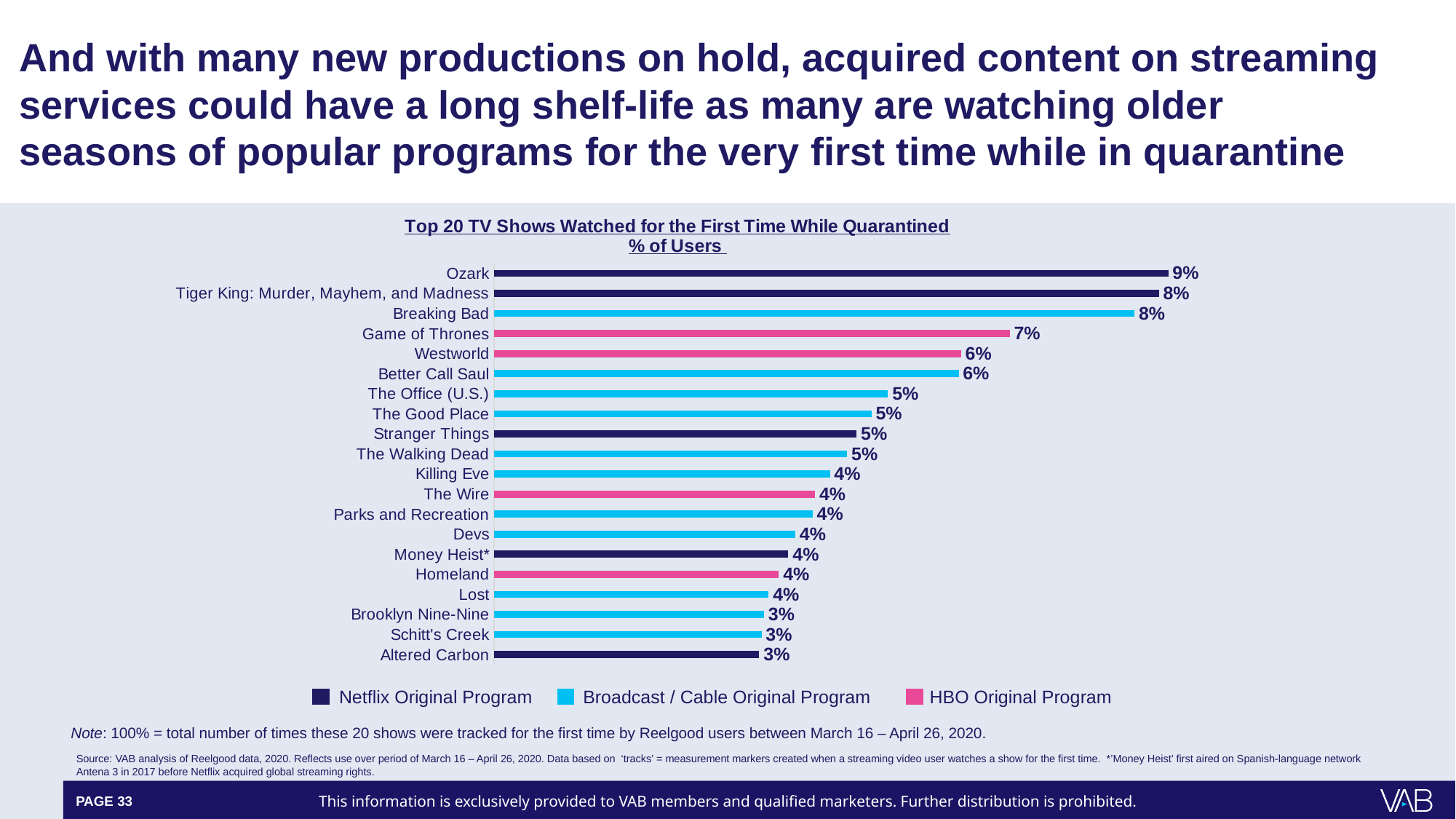
What is the value shown for Better Call Saul? 6% What is the value shown for Altered Carbon? 3% What percentage of users watched Ozark for the first time while quarantined? 9% Which TV show has the highest percentage of users in the chart? Ozark Which legend category is shown in pink? HBO Original Program Which has a larger value, Breaking Bad or Westworld? Breaking Bad How many program categories does the legend list? 3 What is the value shown for Stranger Things? 5% How many TV shows are listed in the chart? 20 What is the value shown for Game of Thrones? 7% What is the difference between the values for Ozark and Game of Thrones? 2 percentage points What type of chart is shown on the slide? Bar chart